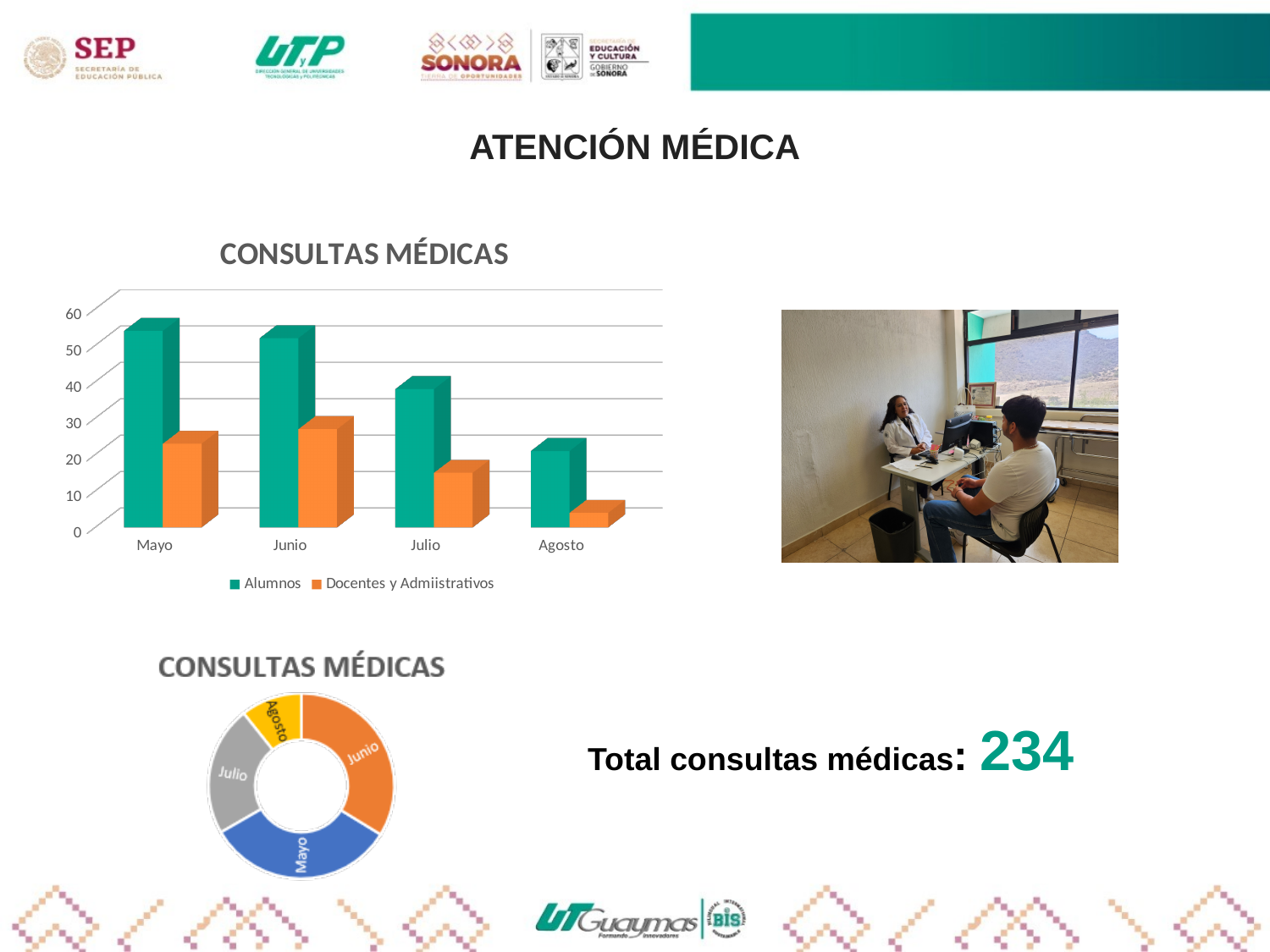
In the top bar chart, is the value for Docentes y Admiistrativos in Agosto greater or less than 10? less In the top bar chart, do the Alumnos values rise or fall from Mayo to Agosto? fall In the top bar chart, how many months are shown on the x axis? 4 In the top bar chart, how many series does the legend list? 2 In the top bar chart, is the value for Alumnos in Mayo greater or less than 50? greater In the top bar chart, what are the two legend entries? Alumnos; Docentes y Admiistrativos In the top bar chart, which month has the lowest value for Alumnos? Agosto In the top bar chart, is the value for Alumnos in Julio greater or less than 30? greater In the bottom doughnut chart titled CONSULTAS MÉDICAS, which month has the smallest slice? Agosto In the top bar chart, which month has the highest value for Docentes y Admiistrativos? Junio In the top bar chart, which is larger in Julio: Alumnos or Docentes y Admiistrativos? Alumnos What kind of chart is the top chart titled CONSULTAS MÉDICAS? bar chart